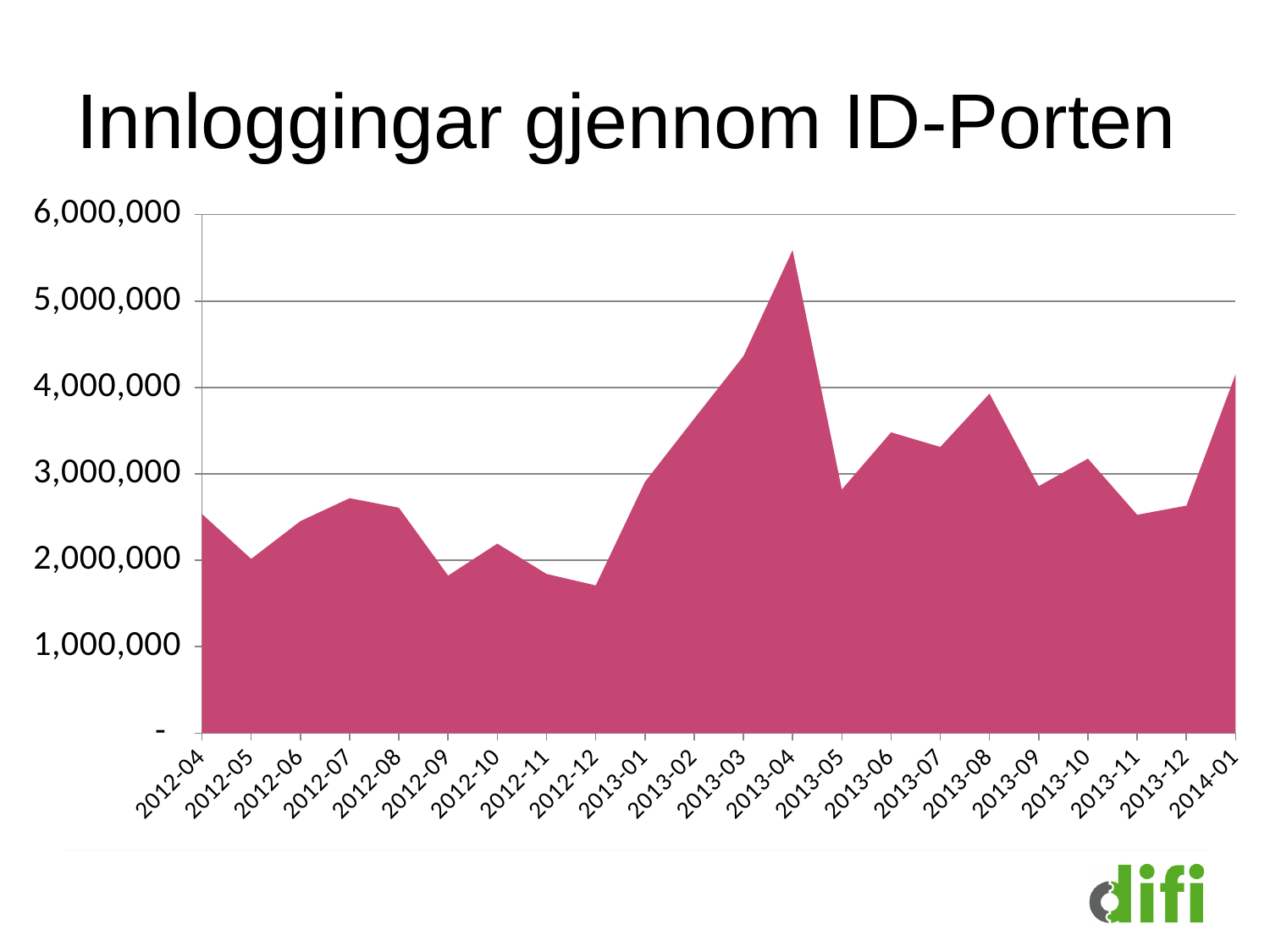
Which month has the highest number of logins? 2013-04 Which month has more logins, 2013-04 or 2013-05? 2013-04 Is the value for 2013-03 greater or less than 4,000,000? greater What is the title of the chart? Innloggingar gjennom ID-Porten How many months are plotted along the x axis? 22 Do the values rise or fall from 2012-12 to 2013-04? rise What kind of chart is shown on the slide? Area chart Is the value for 2013-04 greater or less than 5,000,000? greater Which month has the lowest number of logins? 2012-12 What is the first month shown on the x axis? 2012-04 Is the value for 2013-11 greater or less than 3,000,000? less